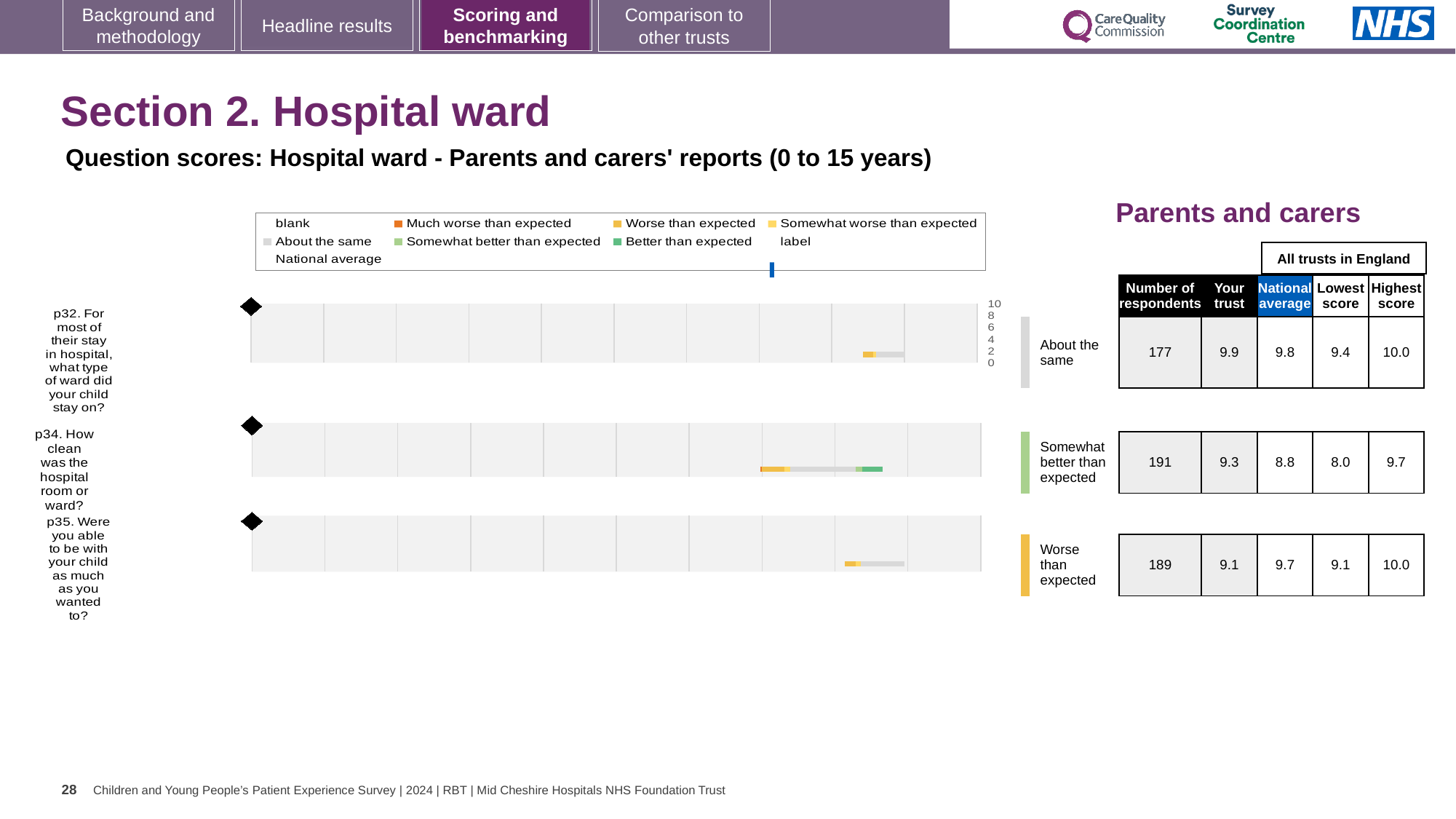
What is the highest score across all trusts in England for p34? 9.7 What kind of chart is used to show the question scores for p32, p34 and p35? bar chart Which benchmark category is p34 (how clean was the hospital room or ward) placed in? Somewhat better than expected How many questions (p32, p34, p35) are plotted on the slide? 3 By how much does the trust's score for p34 exceed the national average? 0.5 Which question has the highest 'Your trust' score? p32 What is the national average score for p34 (how clean was the hospital room or ward)? 8.8 By how much is the trust's score for p35 below the national average? 0.6 How many respondents answered p35 (were you able to be with your child as much as you wanted to)? 189 What is the 'Your trust' score for p32 (what type of ward did your child stay on)? 9.9 Which has the higher 'Your trust' score, p32 or p35? p32 Which question has the lowest 'Your trust' score? p35